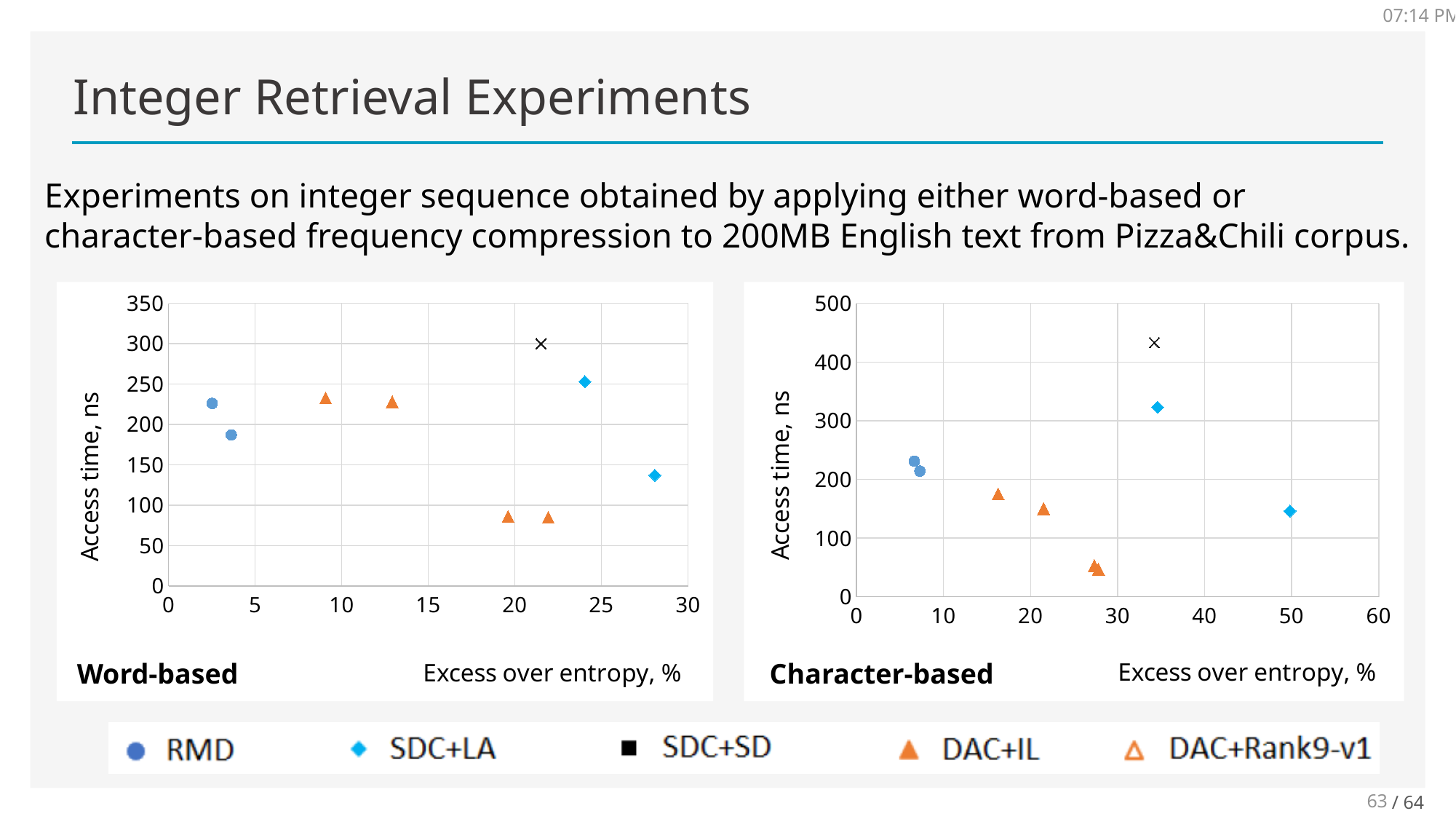
In the Character-based chart, is the access time of the SDC+LA point at about 50% excess greater or less than 200? less What is the x-axis title of the Word-based chart? Excess over entropy, % What is the y-axis title of the Character-based chart? Access time, ns In the Character-based chart, are the two lowest DAC+IL points greater or less than 100 ns? less In the Character-based chart, is the access time of the highest plotted point greater or less than 400? greater What kind of chart is the Word-based chart? scatter chart In the Character-based chart, which has the higher access time: the RMD points or the DAC+IL points? RMD How many series does the legend list? 5 What is the maximum value shown on the y axis of the Character-based chart? 500